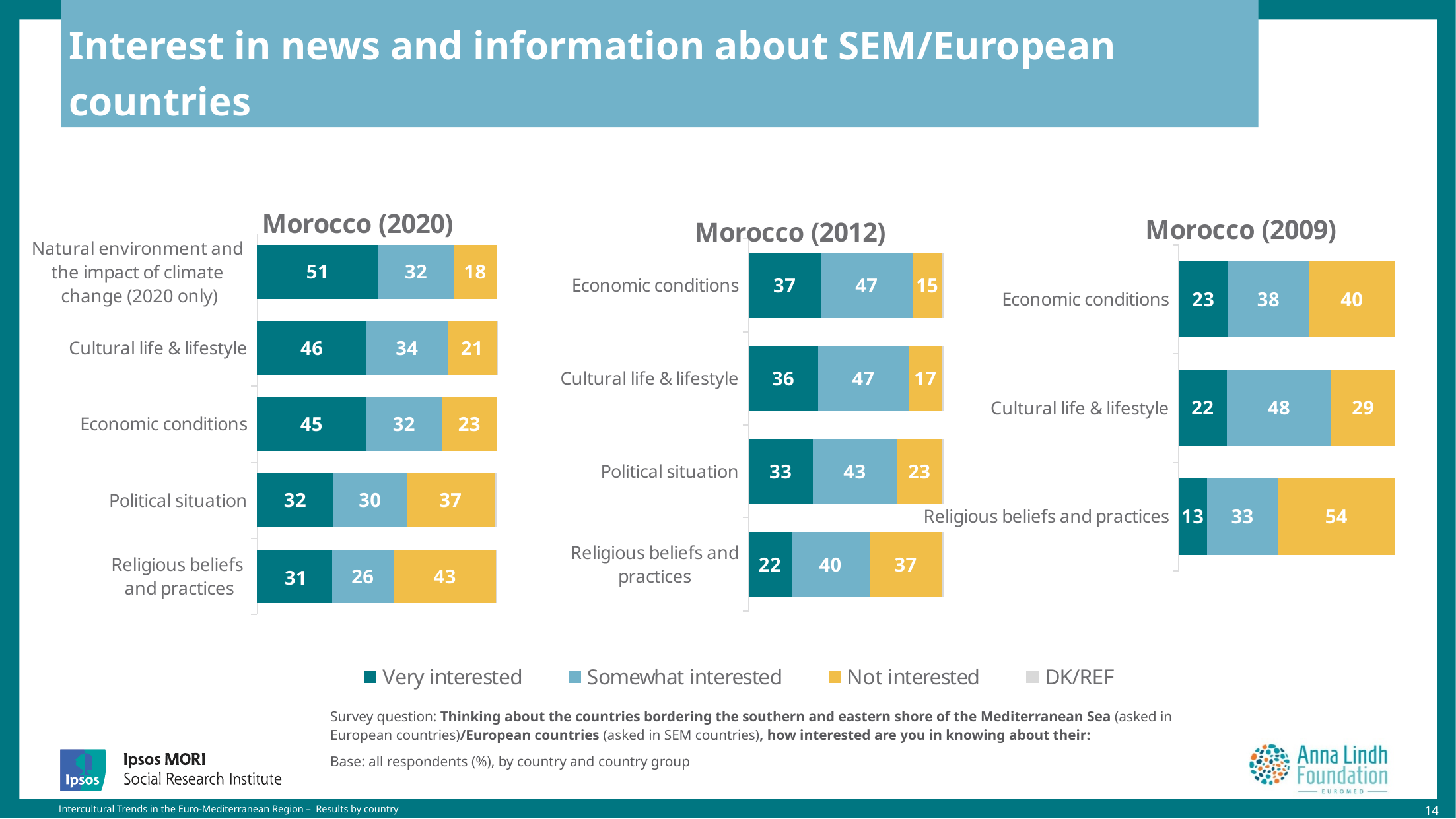
In the Morocco (2012) chart, what is the 'Not interested' value for Political situation? 23 In the Morocco (2020) chart, which is larger: the 'Not interested' value for Political situation or for Religious beliefs and practices? Religious beliefs and practices In the Morocco (2020) chart, what percentage is 'Very interested' in Natural environment and the impact of climate change? 51 In the Morocco (2012) chart, what is the difference between the 'Somewhat interested' values for Economic conditions and Religious beliefs and practices? 7 How many categories are shown in the Morocco (2020) chart? 5 In the Morocco (2009) chart, which category has the lowest 'Very interested' value? Religious beliefs and practices What kind of chart is the Morocco (2012) chart? Stacked bar chart In the Morocco (2020) chart, which category has the highest 'Very interested' value? Natural environment and the impact of climate change (2020 only) In the Morocco (2009) chart, what is the 'Somewhat interested' value for Cultural life & lifestyle? 48 In the Morocco (2009) chart, what is the total of the Economic conditions bar (Very interested + Somewhat interested + Not interested)? 101 How many categories are shown in the Morocco (2009) chart? 3 How many series does the legend list? 4